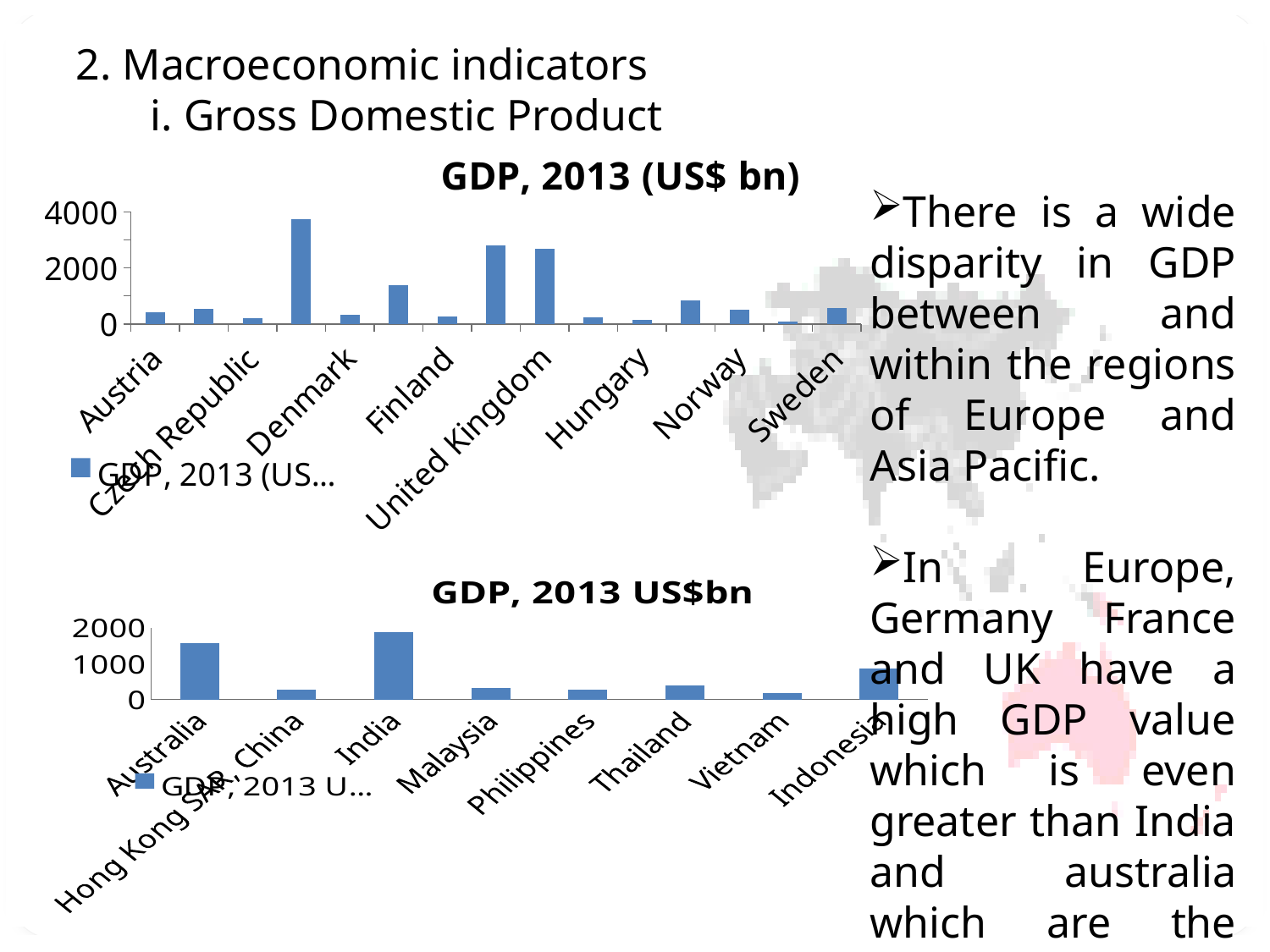
How many categories are shown in the bottom chart 'GDP, 2013 US$bn'? 8 In the top chart 'GDP, 2013 (US$ bn)', which is larger, the value for United Kingdom or the value for Austria? United Kingdom In the bottom chart 'GDP, 2013 US$bn', which is larger, the value for Thailand or the value for Vietnam? Thailand In the top chart 'GDP, 2013 (US$ bn)', is the value for United Kingdom greater or less than 2000? greater In the bottom chart 'GDP, 2013 US$bn', is the value for Australia greater or less than 1000? greater How many series does the legend of the top chart 'GDP, 2013 (US$ bn)' list? 1 In the top chart 'GDP, 2013 (US$ bn)', which is larger, the value for Norway or the value for Hungary? Norway In the top chart 'GDP, 2013 (US$ bn)', is the value for Austria greater or less than 2000? less What type of chart is the top chart titled 'GDP, 2013 (US$ bn)'? Bar chart What is the title of the bottom chart on the slide? GDP, 2013 US$bn In the bottom chart 'GDP, 2013 US$bn', which category has the lowest value? Vietnam In the bottom chart 'GDP, 2013 US$bn', which category has the highest value? India